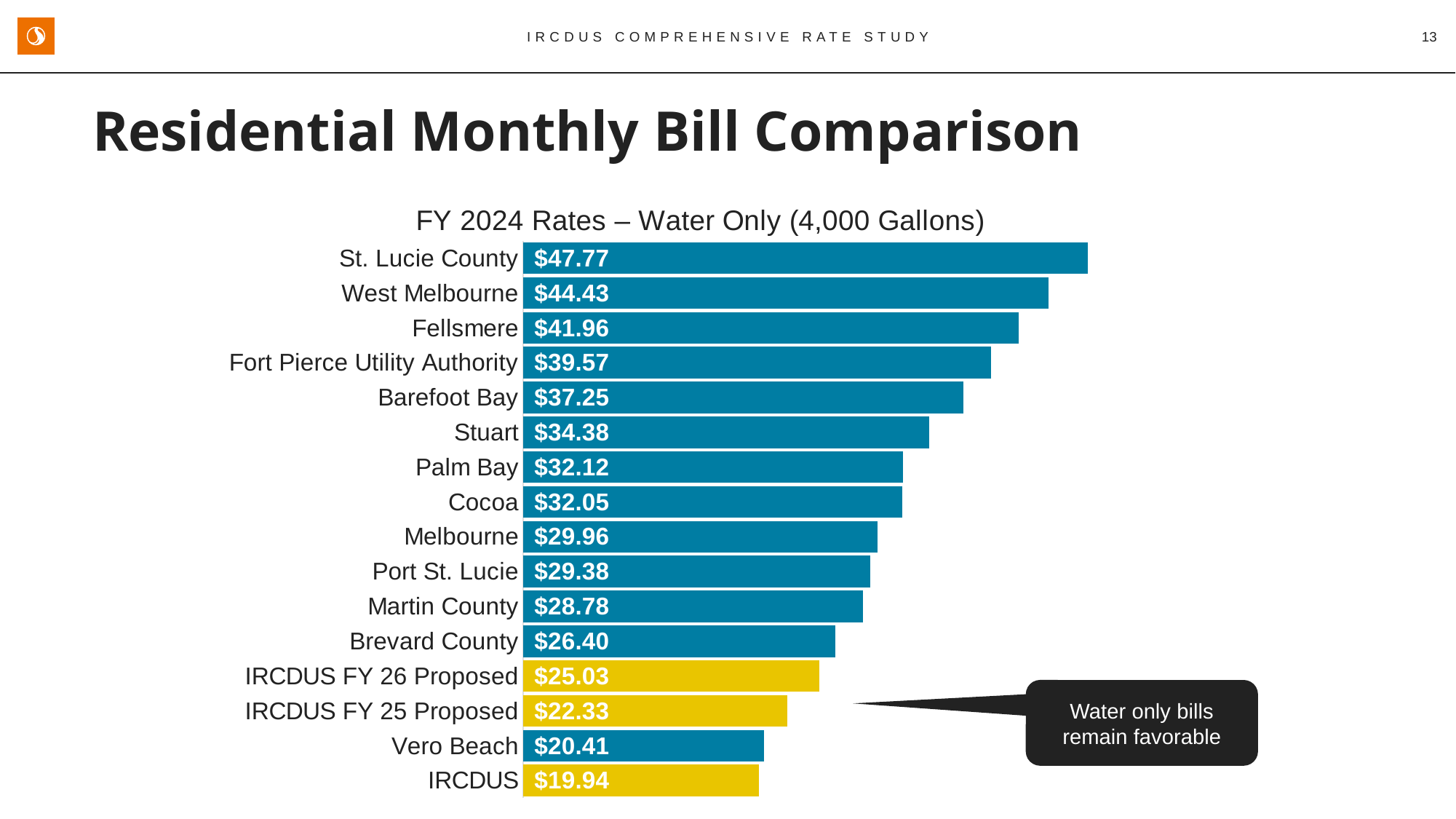
Which has the larger monthly bill, Barefoot Bay or Stuart? Barefoot Bay What is the value shown for Vero Beach? $20.41 What kind of chart is shown on the slide? Bar chart How many utilities or rate scenarios are shown on the chart? 16 What is the difference between the St. Lucie County bill and the IRCDUS bill? $27.83 Which utility has the lowest monthly bill on the chart? IRCDUS What is the difference between the IRCDUS FY 26 Proposed bill and the IRCDUS FY 25 Proposed bill? $2.70 What is the value shown for IRCDUS FY 26 Proposed? $25.03 What is the title of the chart? FY 2024 Rates – Water Only (4,000 Gallons) Which utility has the highest monthly bill on the chart? St. Lucie County Which has the larger monthly bill, Melbourne or Port St. Lucie? Melbourne What is the monthly water-only bill shown for Fellsmere? $41.96